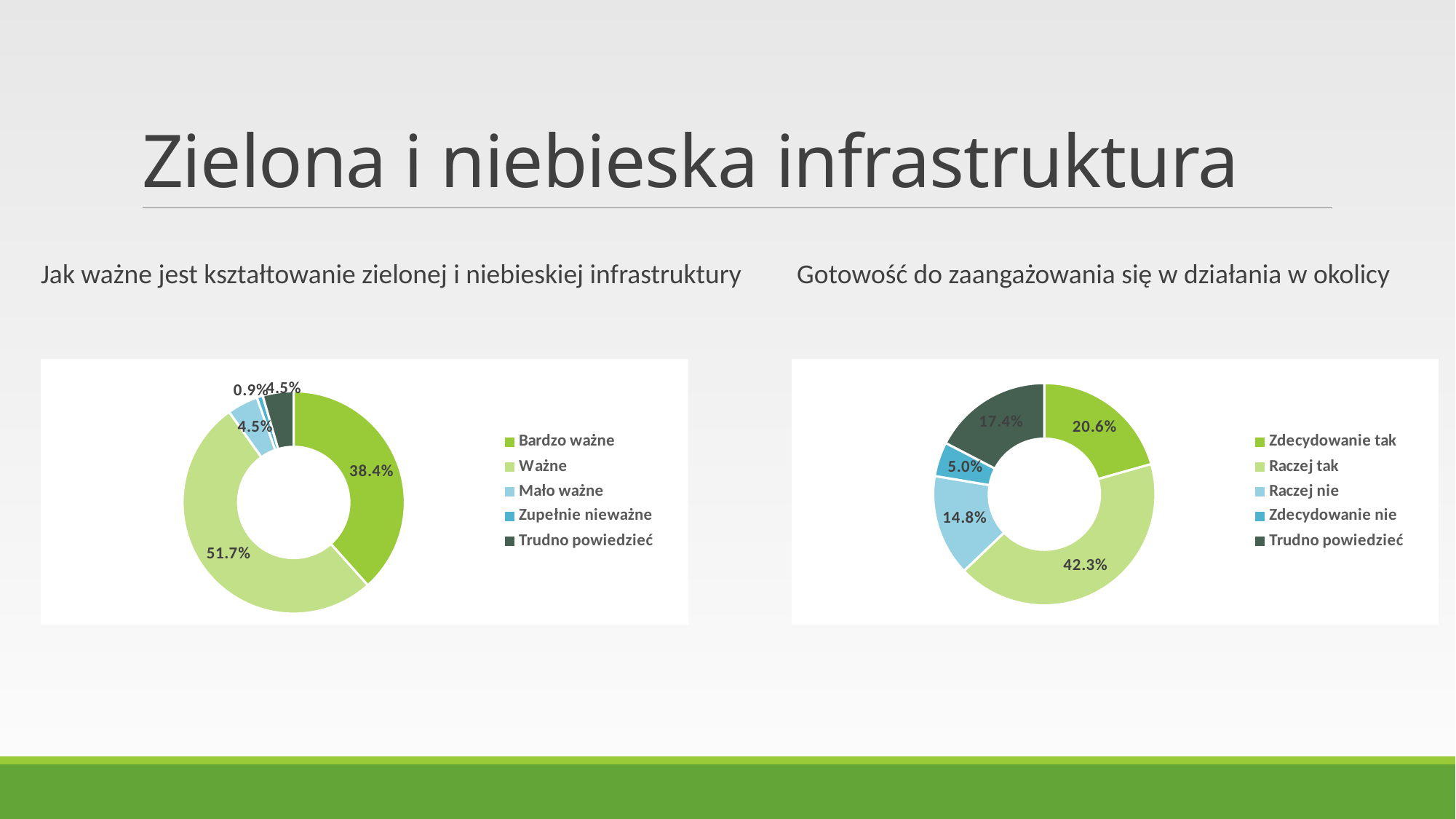
In the left chart (Jak ważne jest kształtowanie zielonej i niebieskiej infrastruktury), which category has the smallest share? Zupełnie nieważne In the left chart (Jak ważne jest kształtowanie zielonej i niebieskiej infrastruktury), how many categories does the legend list? 5 In the right chart (Gotowość do zaangażowania się w działania w okolicy), what is the difference between Zdecydowanie tak and Trudno powiedzieć? 3.2% In the right chart (Gotowość do zaangażowania się w działania w okolicy), which is larger: Raczej nie or Trudno powiedzieć? Trudno powiedzieć In the left chart (Jak ważne jest kształtowanie zielonej i niebieskiej infrastruktury), what percentage is shown for Bardzo ważne? 38.4% In the right chart (Gotowość do zaangażowania się w działania w okolicy), what percentage is shown for Raczej tak? 42.3% What kind of chart is the right chart (Gotowość do zaangażowania się w działania w okolicy)? doughnut chart In the right chart (Gotowość do zaangażowania się w działania w okolicy), which category has the largest share? Raczej tak In the left chart (Jak ważne jest kształtowanie zielonej i niebieskiej infrastruktury), what is the difference between the Ważne and Bardzo ważne shares? 13.3% In the left chart (Jak ważne jest kształtowanie zielonej i niebieskiej infrastruktury), what percentage is shown for Ważne? 51.7% In the right chart (Gotowość do zaangażowania się w działania w okolicy), what percentage is shown for Zdecydowanie nie? 5.0% In the left chart (Jak ważne jest kształtowanie zielonej i niebieskiej infrastruktury), what colour is the Trudno powiedzieć slice? dark green